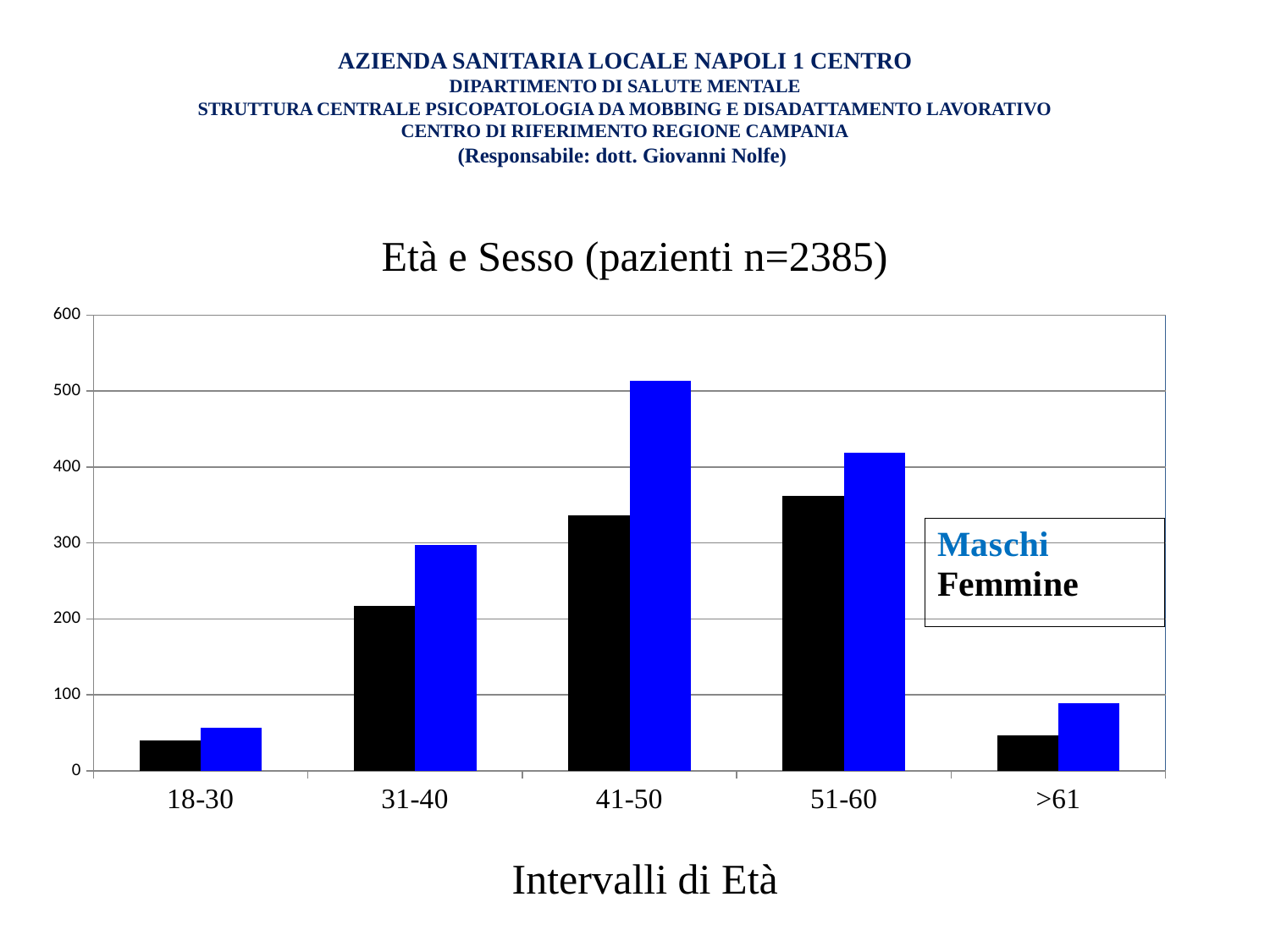
Which age interval has the tallest black bar? 51-60 How many age intervals are shown on the x axis of the chart? 5 Is the value of the blue bar for 41-50 greater or less than 500? greater In the 41-50 interval, which bar is taller, the black bar or the blue bar? the blue bar What is the title of the chart? Età e Sesso (pazienti n=2385) Is the value of the black bar for >61 greater or less than 100? less How many series does the legend of the chart list? 2 Do the blue bars rise or fall from 18-30 to 41-50? rise Is the value of the black bar for 31-40 greater or less than 200? greater What kind of chart is shown on the slide? bar chart Which age interval has the tallest blue bar? 41-50 Which age interval has the shortest blue bar? 18-30